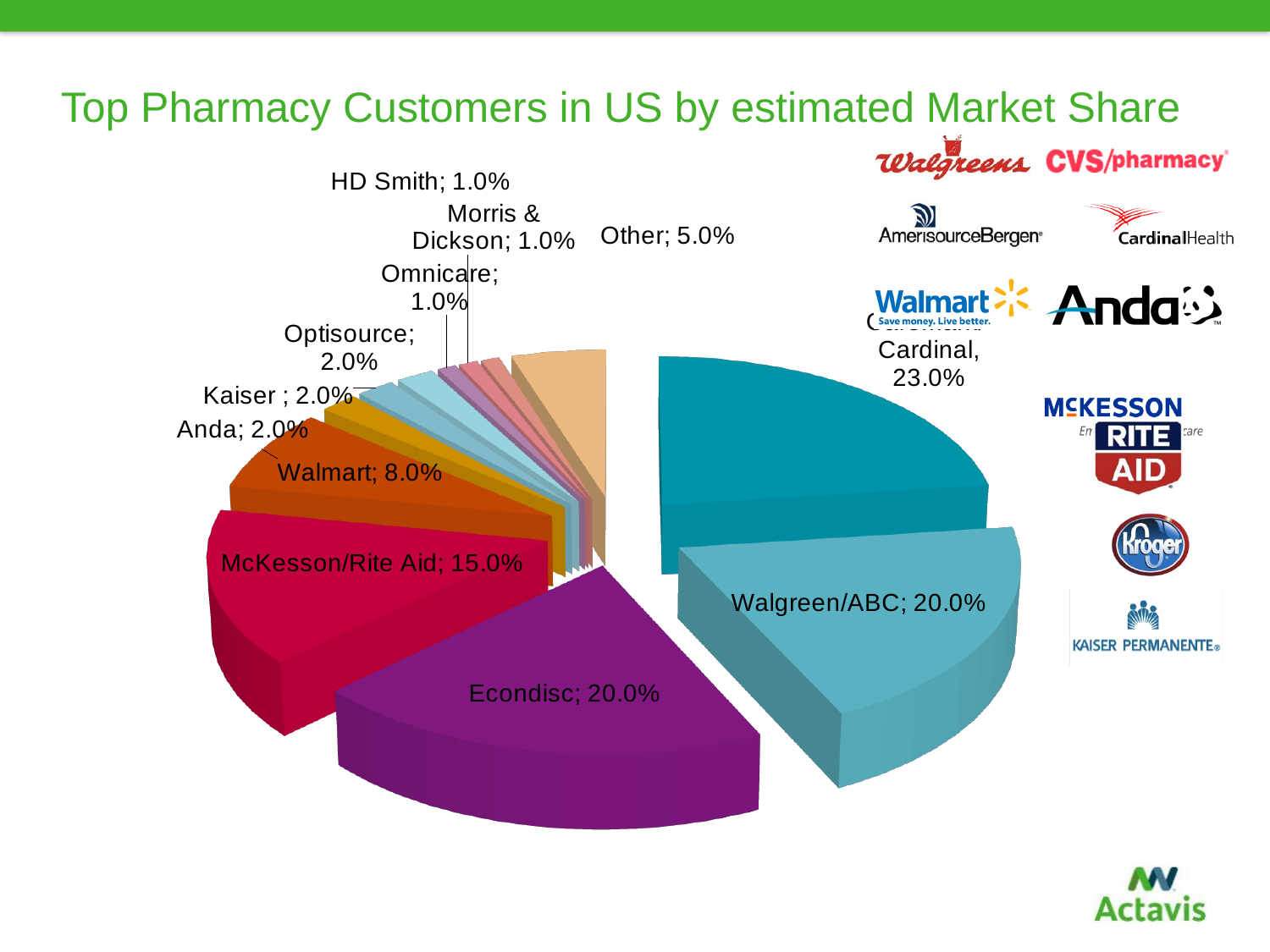
What is the market share shown for Cardinal? 23.0% What is the market share shown for McKesson/Rite Aid? 15.0% What is the title of the chart? Top Pharmacy Customers in US by estimated Market Share What is the difference between the market shares of Cardinal and Walgreen/ABC? 3.0% Which is larger, the slice for Walmart or the slice for Other? Walmart What is the market share shown for Walmart? 8.0% What is the difference between the market shares of McKesson/Rite Aid and Walmart? 7.0% What share of the pie does Econdisc represent? 20.0% How many slices does the pie chart have? 12 What kind of chart is shown on the slide? Pie chart Which customer has the largest slice of the pie? Cardinal What is the market share shown for Other? 5.0%